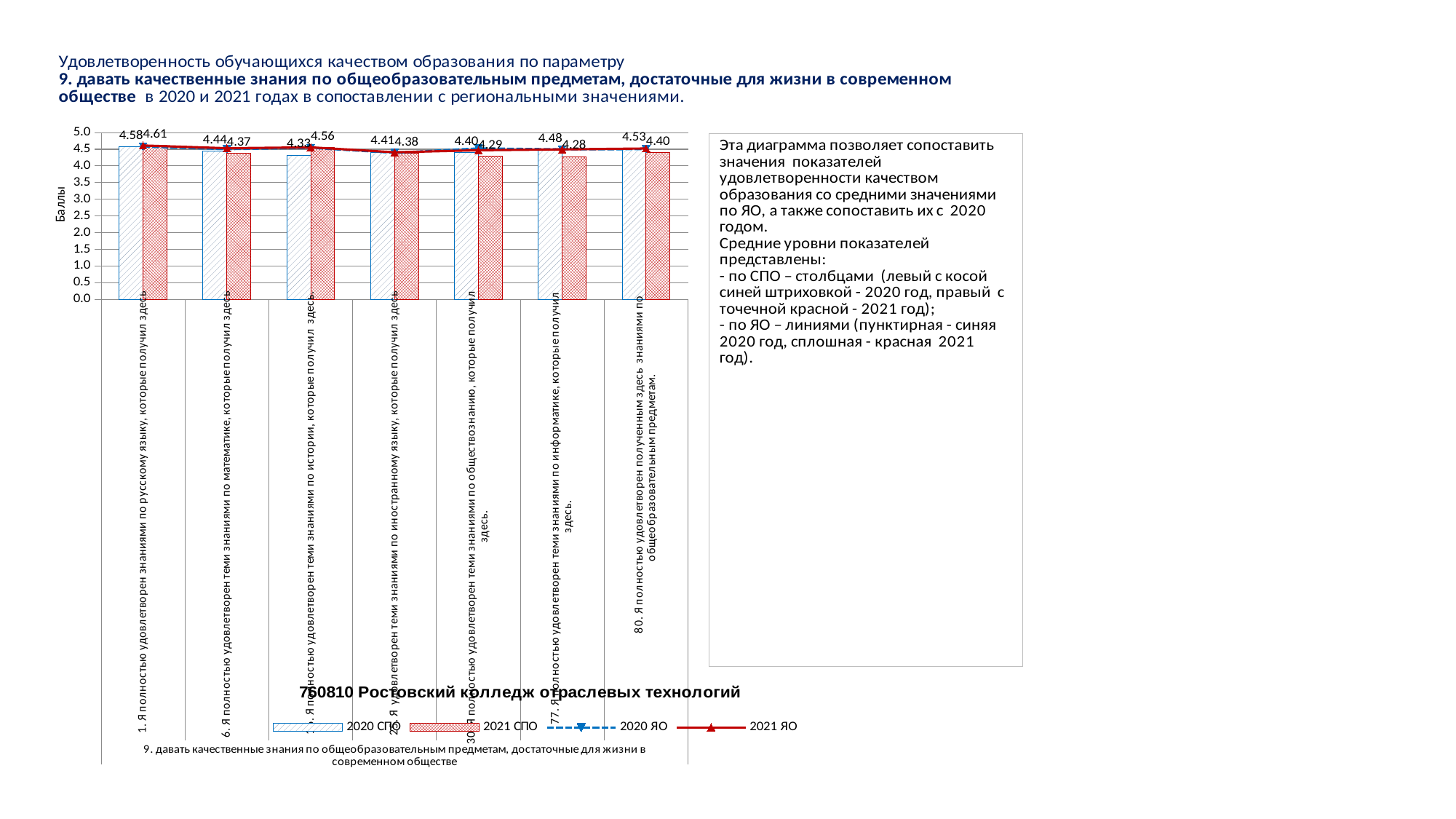
What is the label of the vertical axis of the chart? Баллы Is the 2021 СПО value for the social studies (обществознанию) category greater or less than 4.0? greater What is the 2020 СПО value for the category about knowledge of Russian language (русскому языку)? 4.58 How many series does the chart legend list? 4 What is the 2021 СПО value for the category about knowledge of mathematics (математике)? 4.37 What is the difference between the 2021 СПО and 2020 СПО values for the history (истории) category? 0.23 For the informatics (информатике) category, which is larger: the 2020 СПО value or the 2021 СПО value? 2020 СПО (4.48) What is the 2021 СПО value for the category about knowledge of history (истории)? 4.56 What is the 2020 СПО value for category 80 (полученным здесь знаниями по общеобразовательным предметам)? 4.53 What kind of chart is shown on the slide? Combined bar and line chart How many categories are shown on the x axis of the chart? 7 Which category has the highest 2021 СПО value? 1. Я полностью удовлетворен знаниями по русскому языку, которые получил здесь (4.61)